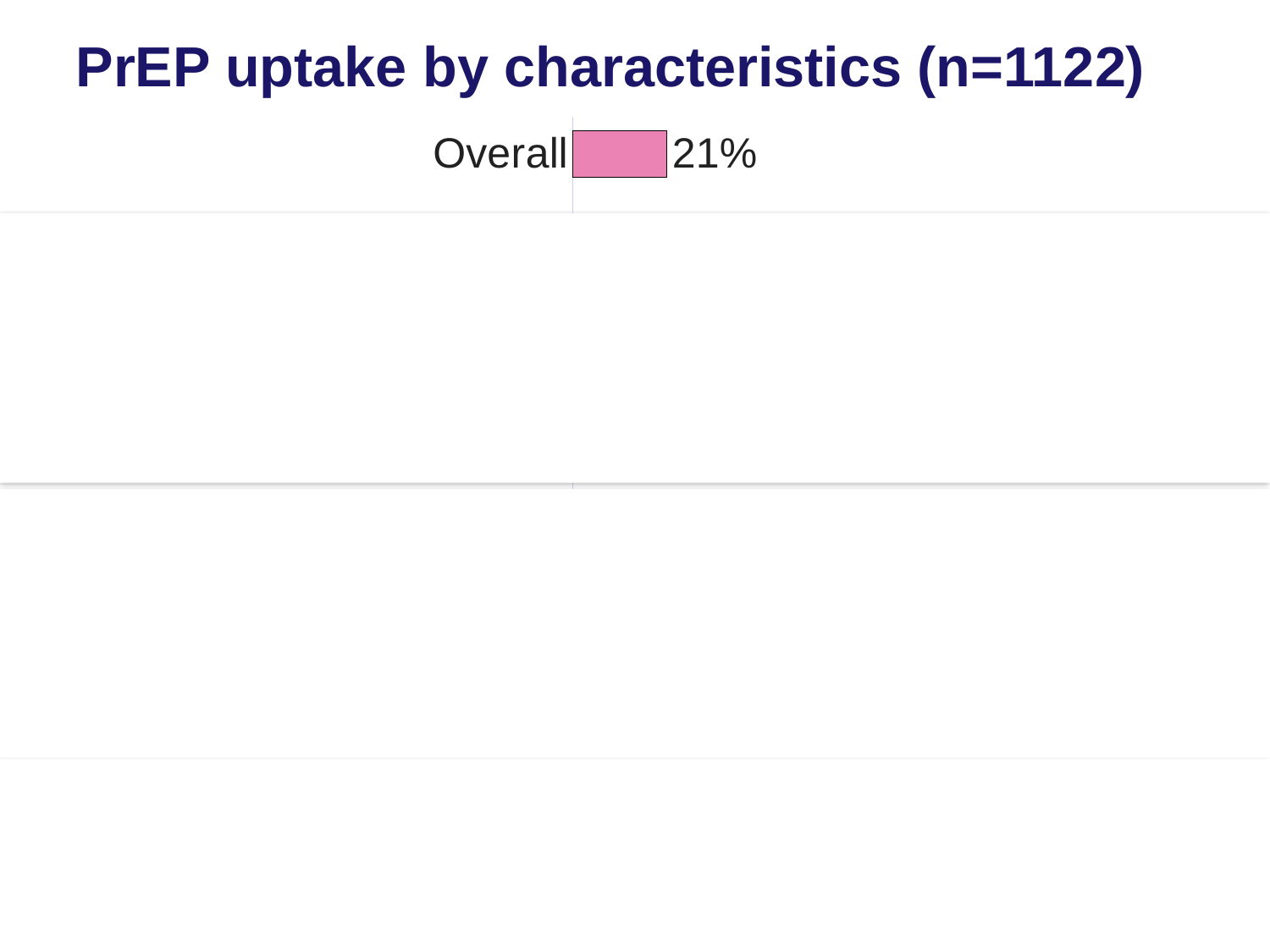
What colour is the bar for Overall? pink How many categories are plotted in the chart? 1 What is the title of the slide's chart? PrEP uptake by characteristics (n=1122) What is the PrEP uptake value shown for Overall? 21% What is the sample size (n) given in the chart title? 1122 What kind of chart is shown on the slide? bar chart